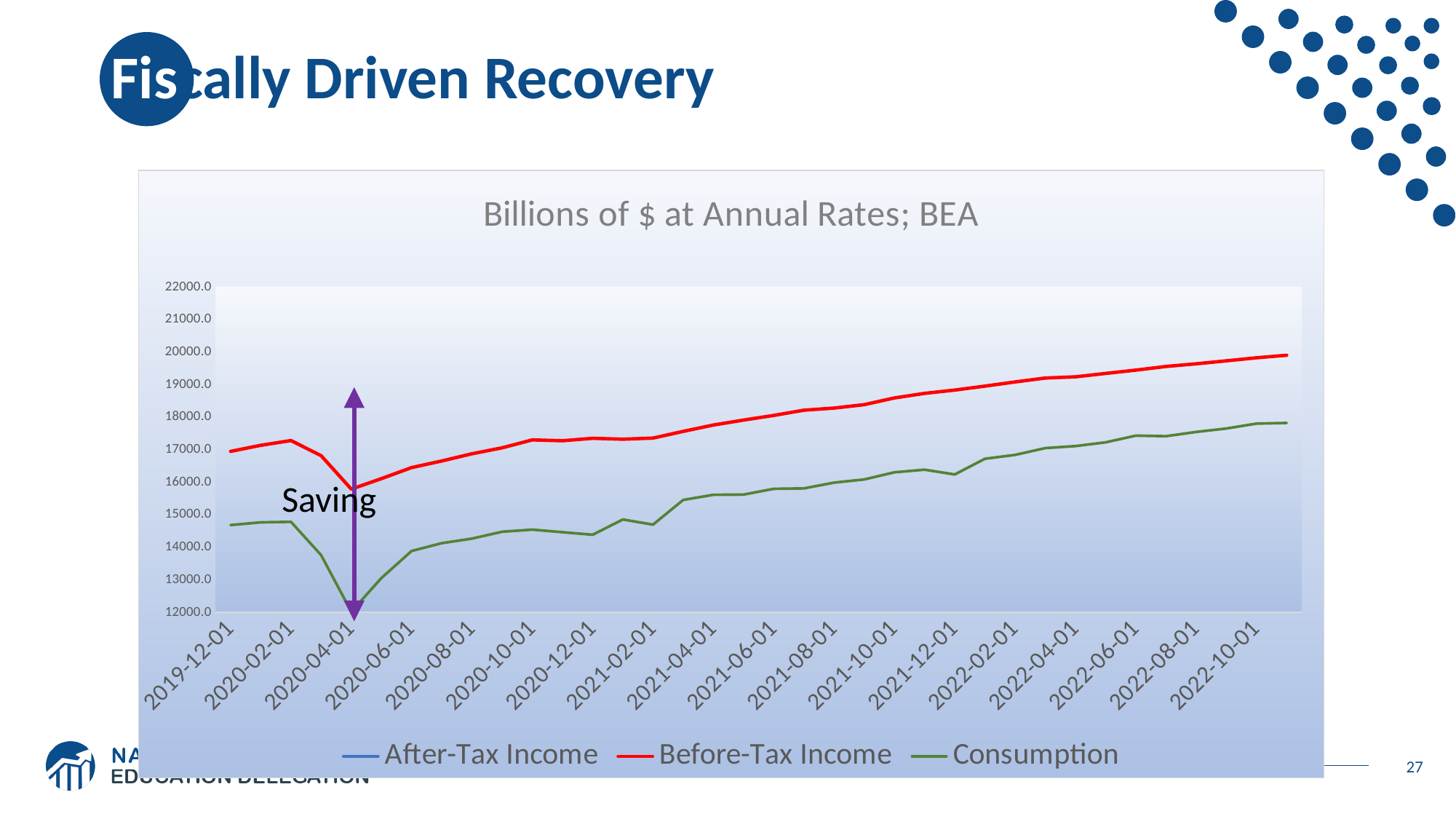
What is the title of the chart? Billions of $ at Annual Rates; BEA At which date does the Consumption line reach its lowest point? 2020-04-01 Does the Before-Tax Income line rise or fall from 2020-06-01 to 2022-10-01? Rise How many date labels are shown on the x axis? 18 How many series does the chart legend list? 3 Is the value of Consumption at 2019-12-01 greater or less than 14000.0? greater Which series is higher at 2021-10-01, Before-Tax Income or Consumption? Before-Tax Income Is the value of Before-Tax Income at 2019-12-01 greater or less than 16000.0? greater What kind of chart is shown on the slide? Line chart Is the value of Consumption at 2020-04-01 greater or less than 13000.0? less What word is written next to the purple vertical arrow on the chart? Saving